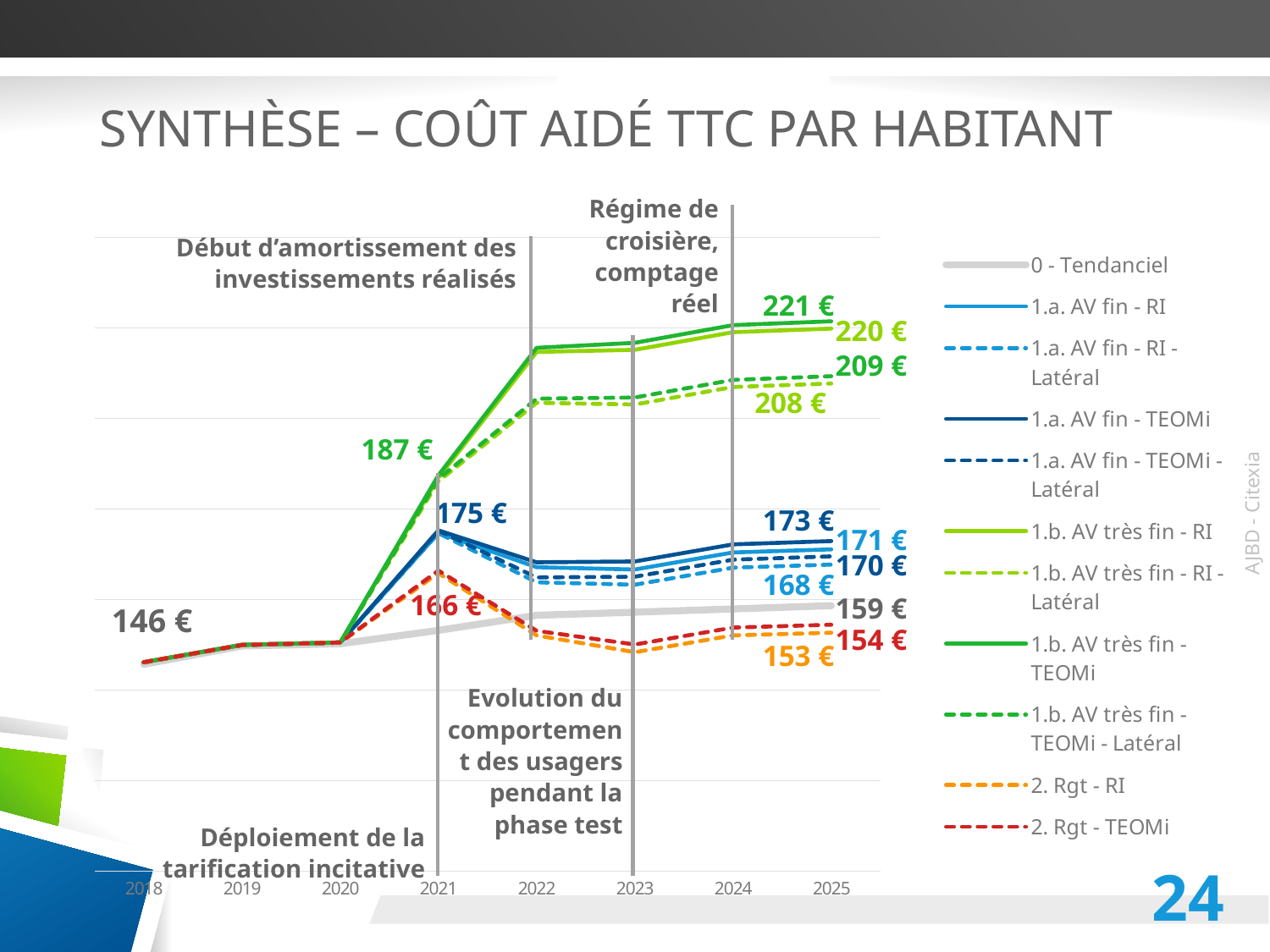
How many series does the legend list? 11 What is the value of the 0 - Tendanciel series in 2025? 159 € What is the value of the 2. Rgt - RI series in 2025? 153 € Does the 0 - Tendanciel series rise or fall from 2018 to 2025? rise What is the value shown for 2018, where all series start? 146 € What is the value of the 1.b. AV très fin - TEOMi series in 2025? 221 € What is the title of the slide containing the chart? SYNTHÈSE – COÛT AIDÉ TTC PAR HABITANT What kind of chart is shown on the slide? line chart What is the difference between the highest 2025 value (221 €) and the lowest 2025 value (153 €)? 68 € How many years are shown on the x axis? 8 Which series has the lowest value in 2025? 2. Rgt - RI Which series has the highest value in 2025? 1.b. AV très fin - TEOMi